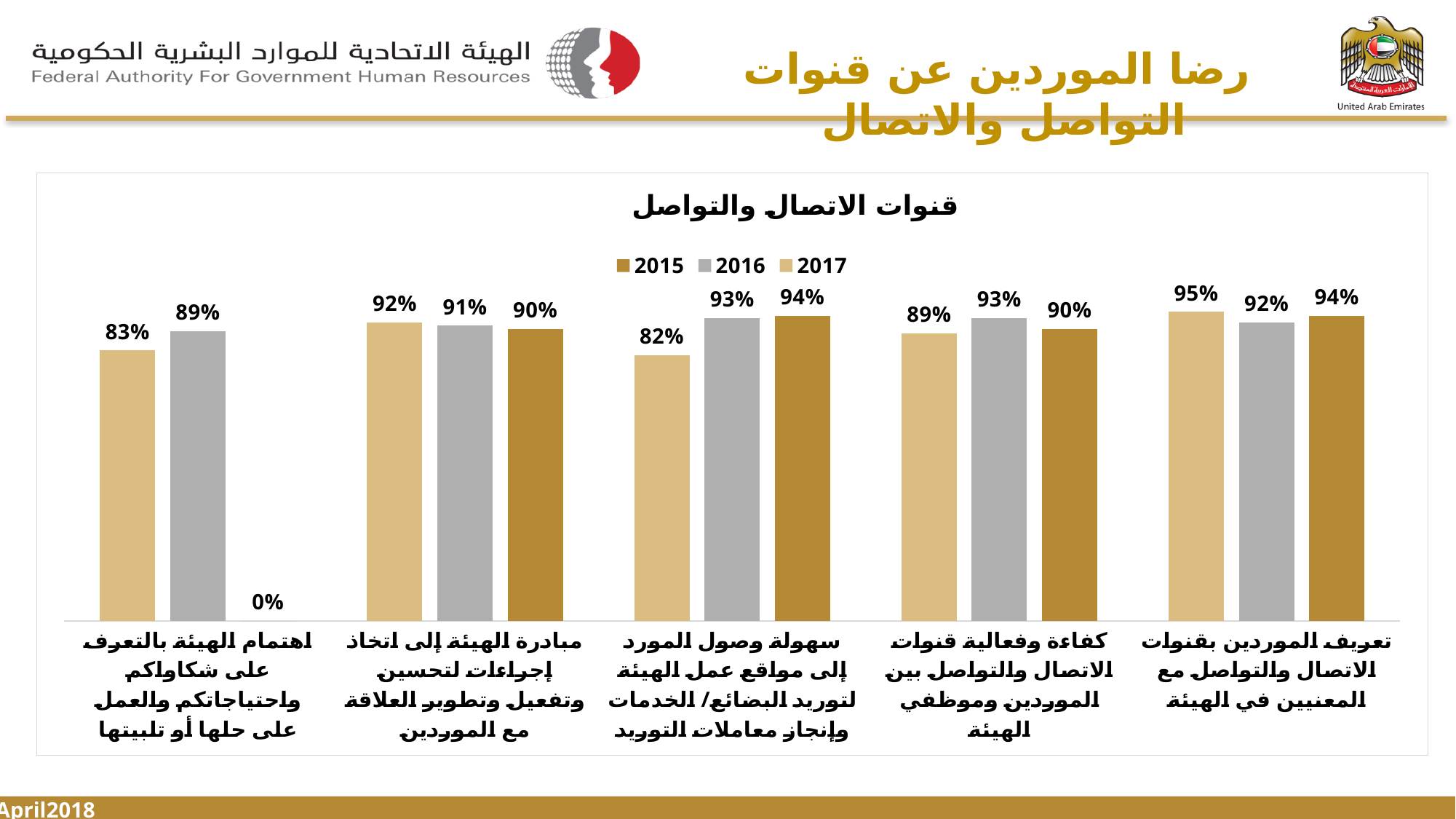
For "كفاءة وفعالية قنوات الاتصال والتواصل بين الموردين وموظفي الهيئة", which year has the larger value, 2016 or 2017? 2016 How many categories are shown on the x axis? 5 What is the 2016 value for "سهولة وصول المورد إلى موقع عمل الهيئة لتوريد البضائع/ الخدمات وإنجاز معاملات التوريد"? 93% What type of chart is shown on the slide? bar chart Which series is shown in gray in the legend? 2016 What is the title of the chart? قنوات الاتصال والتواصل Which category has the highest 2017 value? تعريف الموردين بقنوات الاتصال والتواصل مع المعنيين في الهيئة What is the 2015 value for "اهتمام الهيئة بالتعرف على شكاواكم واحتياجاتكم والعمل على حلها أو تلبيتها"? 0% How many series does the legend list? 3 What is the difference between the 2016 and 2017 values for "سهولة وصول المورد إلى موقع عمل الهيئة لتوريد البضائع/ الخدمات وإنجاز معاملات التوريد"? 11% Which category has the lowest 2017 value? سهولة وصول المورد إلى موقع عمل الهيئة لتوريد البضائع/ الخدمات وإنجاز معاملات التوريد What is the 2017 value for "تعريف الموردين بقنوات الاتصال والتواصل مع المعنيين في الهيئة"? 95%